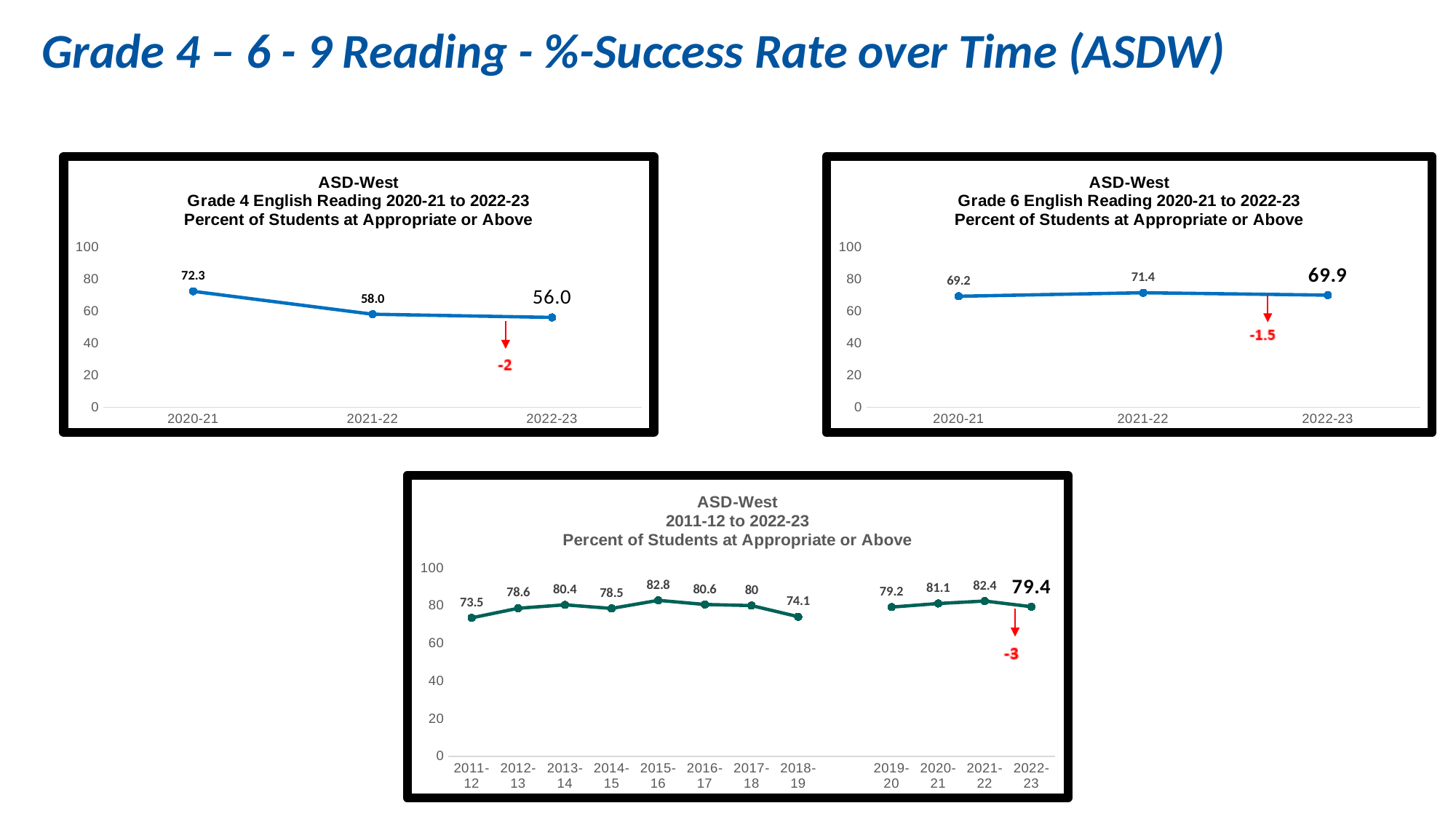
In the bottom chart (ASD-West 2011-12 to 2022-23), which year has the lowest value? 2011-12 In the Grade 4 English Reading chart (top left), what is the value for 2020-21? 72.3 In the Grade 4 English Reading chart (top left), do the values rise or fall from 2020-21 to 2022-23? fall In the Grade 6 English Reading chart (top right), which year has the highest value? 2021-22 In the Grade 6 English Reading chart (top right), which is larger, the value for 2020-21 or the value for 2022-23? 2022-23 In the Grade 6 English Reading chart (top right), what is the value for 2022-23? 69.9 In the bottom chart (ASD-West 2011-12 to 2022-23), what is the difference between the 2021-22 and 2022-23 values? 3 In the Grade 4 English Reading chart (top left), what is the value for 2022-23? 56.0 In the Grade 4 English Reading chart (top left), what is the difference between the 2020-21 and 2021-22 values? 14.3 In the bottom chart (ASD-West 2011-12 to 2022-23), how many data points are plotted? 12 In the bottom chart (ASD-West 2011-12 to 2022-23), which year has the highest value? 2015-16 What type of chart is the Grade 6 English Reading chart (top right)? line chart